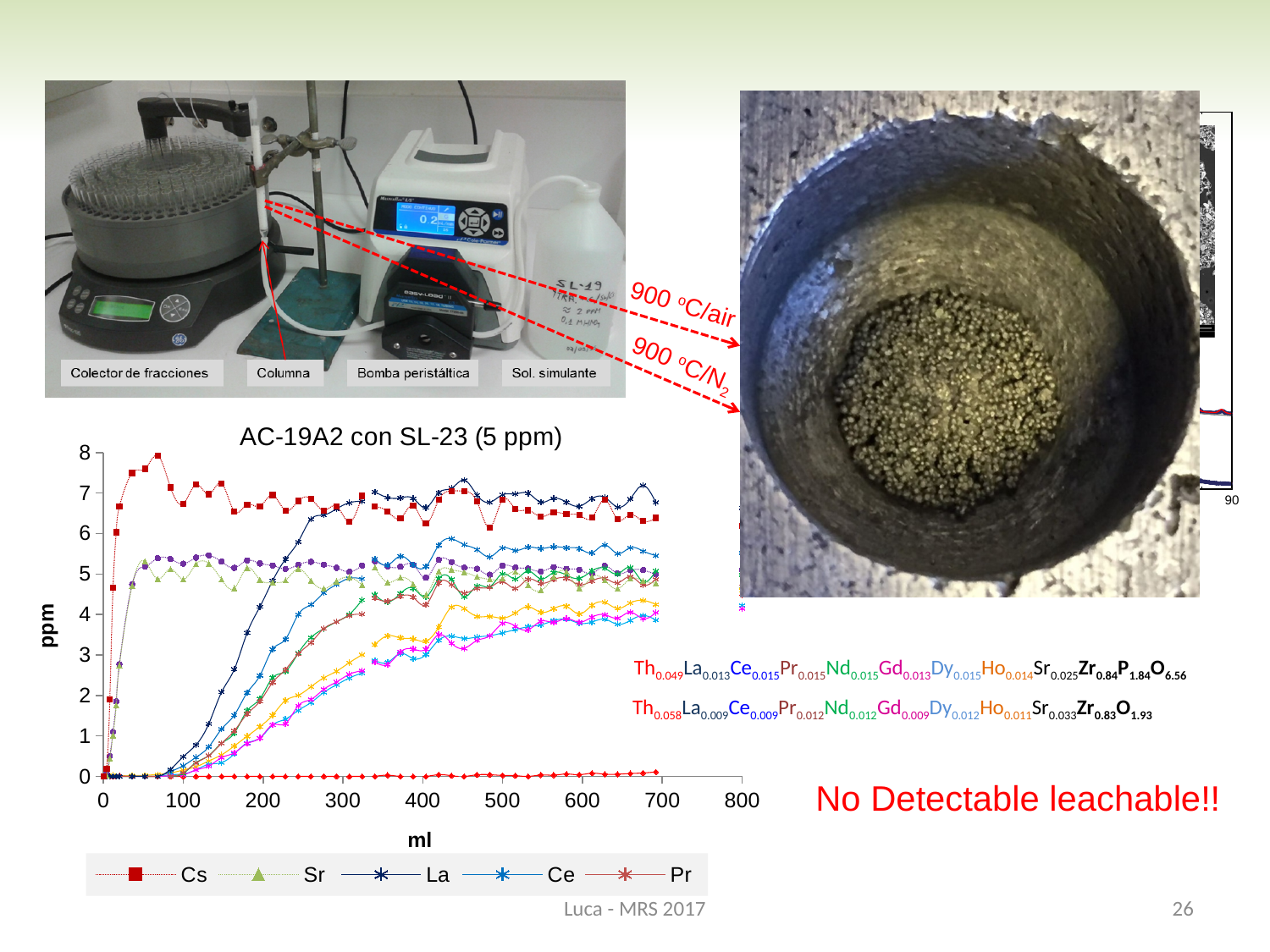
How many series does the chart's legend list? 5 Which series reaches the highest ppm value on the chart? Cs Does the La series rise or fall between 100 ml and 300 ml? rise What kind of chart is shown on the slide? line chart Is the value for Cs at 100 ml greater or less than 6? greater Is the value for La at 300 ml greater or less than 6? greater What is the label of the y axis of the chart? ppm What is the title of the chart on the slide? AC-19A2 con SL-23 (5 ppm) At 100 ml, which series has the larger value, Cs or La? Cs Is the value for Pr at 100 ml greater or less than 1? less